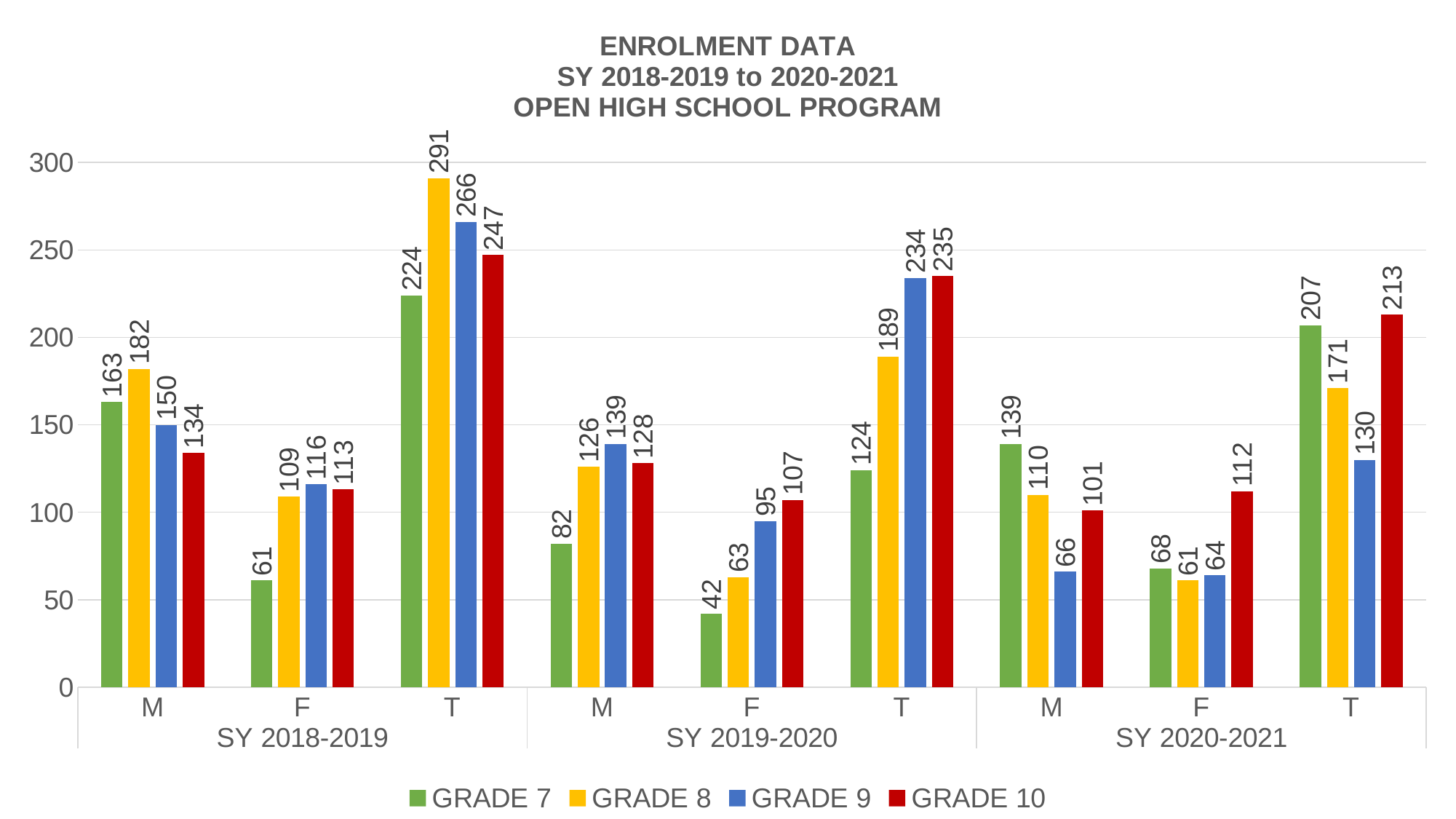
How many series does the legend list? 4 What colour represents Grade 10 in the chart? Red What is the Grade 9 value for M in SY 2020-2021? 66 What kind of chart is shown on the slide? Bar chart What is the Grade 10 value for T in SY 2020-2021? 213 Which is larger: the Grade 7 value for T in SY 2020-2021 or the Grade 8 value for T in SY 2020-2021? Grade 7 What is the Grade 8 value for T in SY 2018-2019? 291 What is the Grade 7 value for F in SY 2019-2020? 42 Which grade has the highest value for T in SY 2018-2019? Grade 8 What is the difference between the Grade 8 and Grade 7 values for M in SY 2018-2019? 19 Which grade has the lowest value for F in SY 2019-2020? Grade 7 How does the Grade 8 value for T change from SY 2018-2019 to SY 2020-2021? It falls